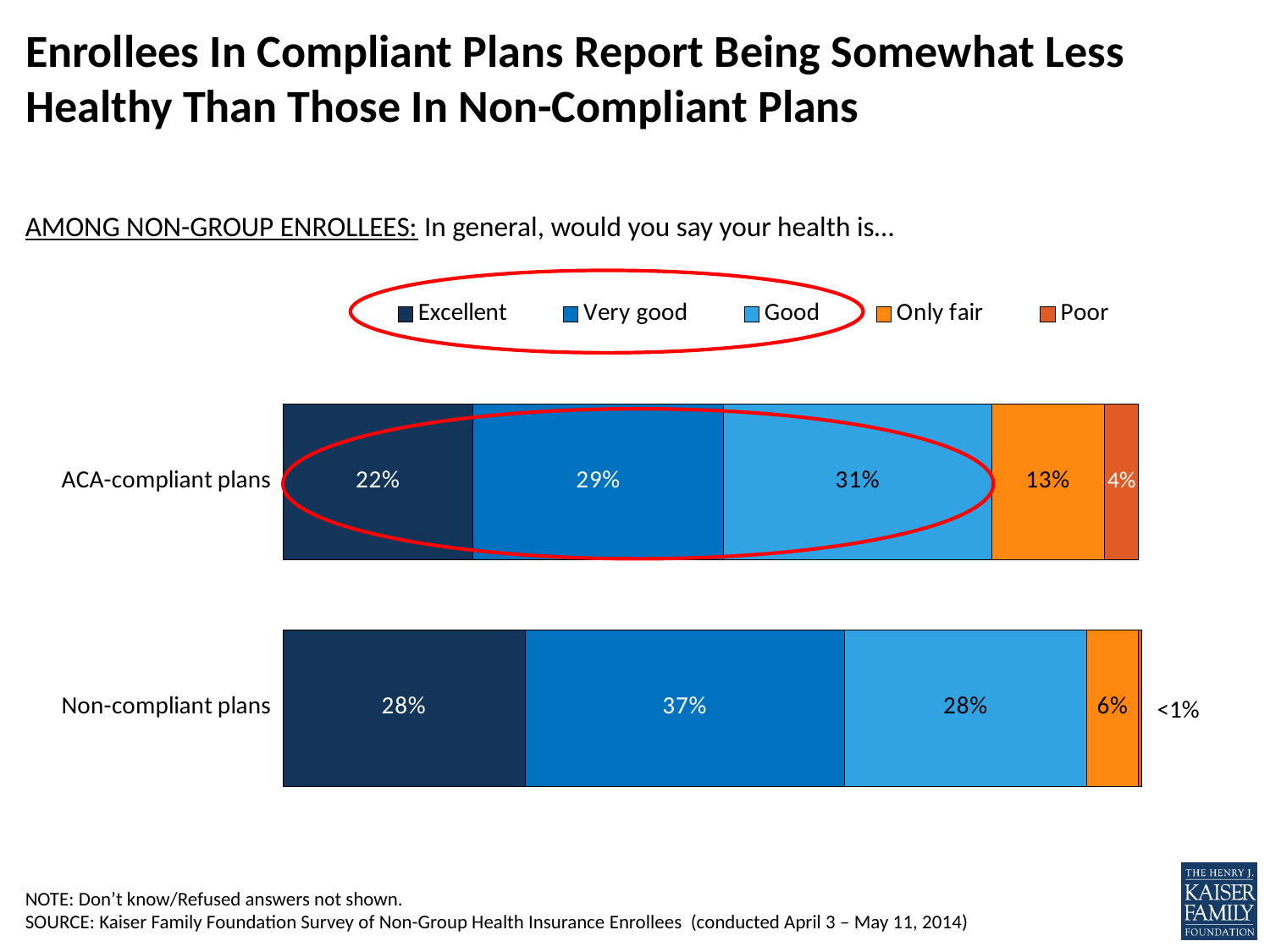
What is the combined share of Excellent, Very good and Good ratings for ACA-compliant plans? 82% How many series does the legend list? 5 What kind of chart is shown on the slide? Stacked bar chart Which group has a larger share of enrollees rating their health as Excellent, ACA-compliant plans or Non-compliant plans? Non-compliant plans How many plan categories are shown in the chart? 2 What percentage of enrollees in Non-compliant plans rate their health as Very good? 37% What percentage of enrollees in Non-compliant plans rate their health as Poor? <1% Which health rating has the smallest share among enrollees in Non-compliant plans? Poor Which health rating has the largest share among enrollees in ACA-compliant plans? Good What is the difference between the Very good share for Non-compliant plans and the Very good share for ACA-compliant plans? 8 percentage points What percentage of enrollees in ACA-compliant plans rate their health as Only fair? 13% What percentage of enrollees in ACA-compliant plans rate their health as Excellent? 22%